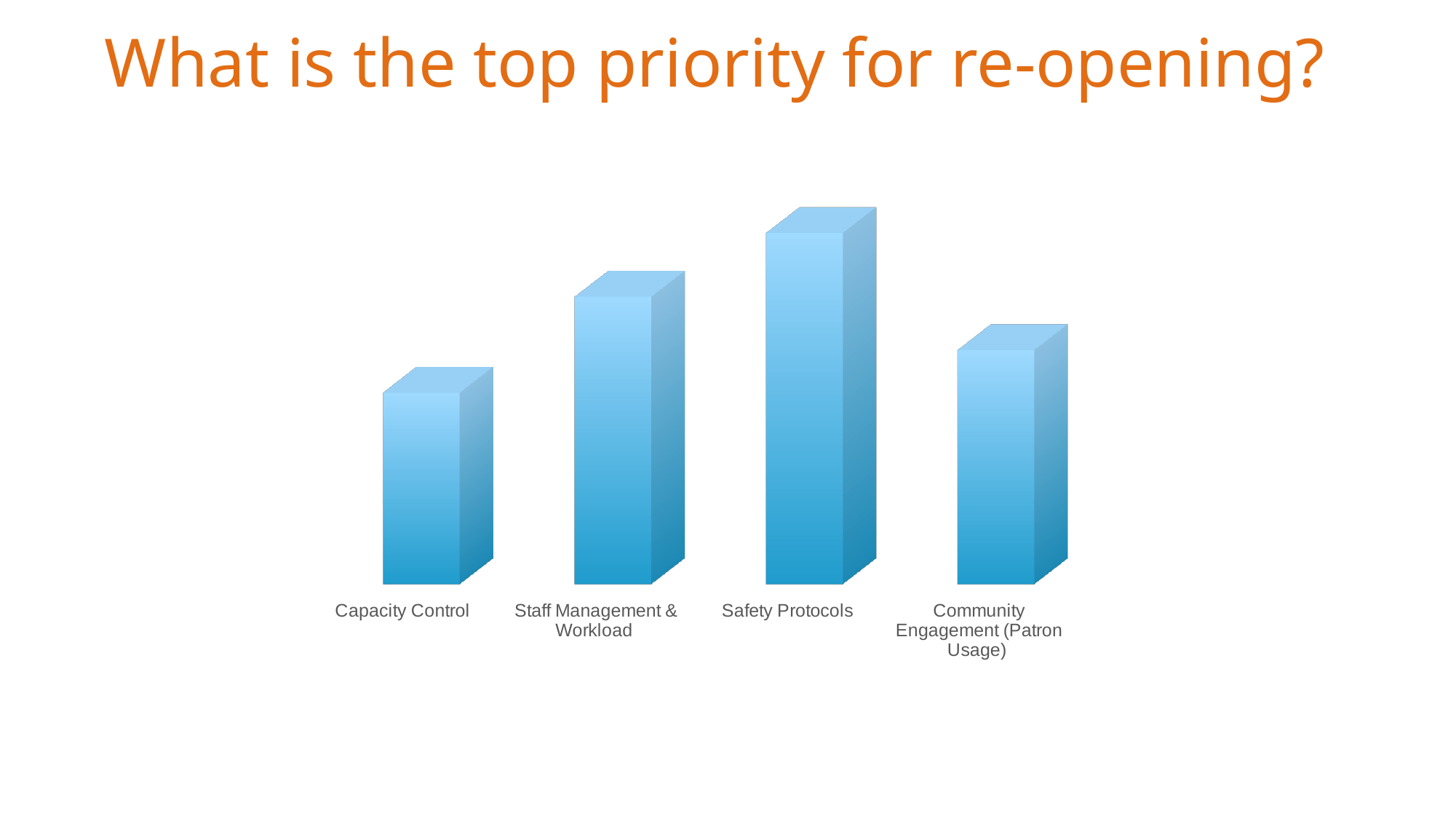
What kind of chart is shown on the slide? Bar chart What colour are the bars in the chart? Blue Which category has the second-highest bar in the chart? Staff Management & Workload How many categories are shown in the chart? 4 Which category has the highest bar in the chart? Safety Protocols Which is larger, the bar for Staff Management & Workload or the bar for Community Engagement (Patron Usage)? Staff Management & Workload Which is larger, the bar for Capacity Control or the bar for Community Engagement (Patron Usage)? Community Engagement (Patron Usage) Which category has the lowest bar in the chart? Capacity Control What is the title of the slide containing the chart? What is the top priority for re-opening? Which is larger, the bar for Safety Protocols or the bar for Staff Management & Workload? Safety Protocols